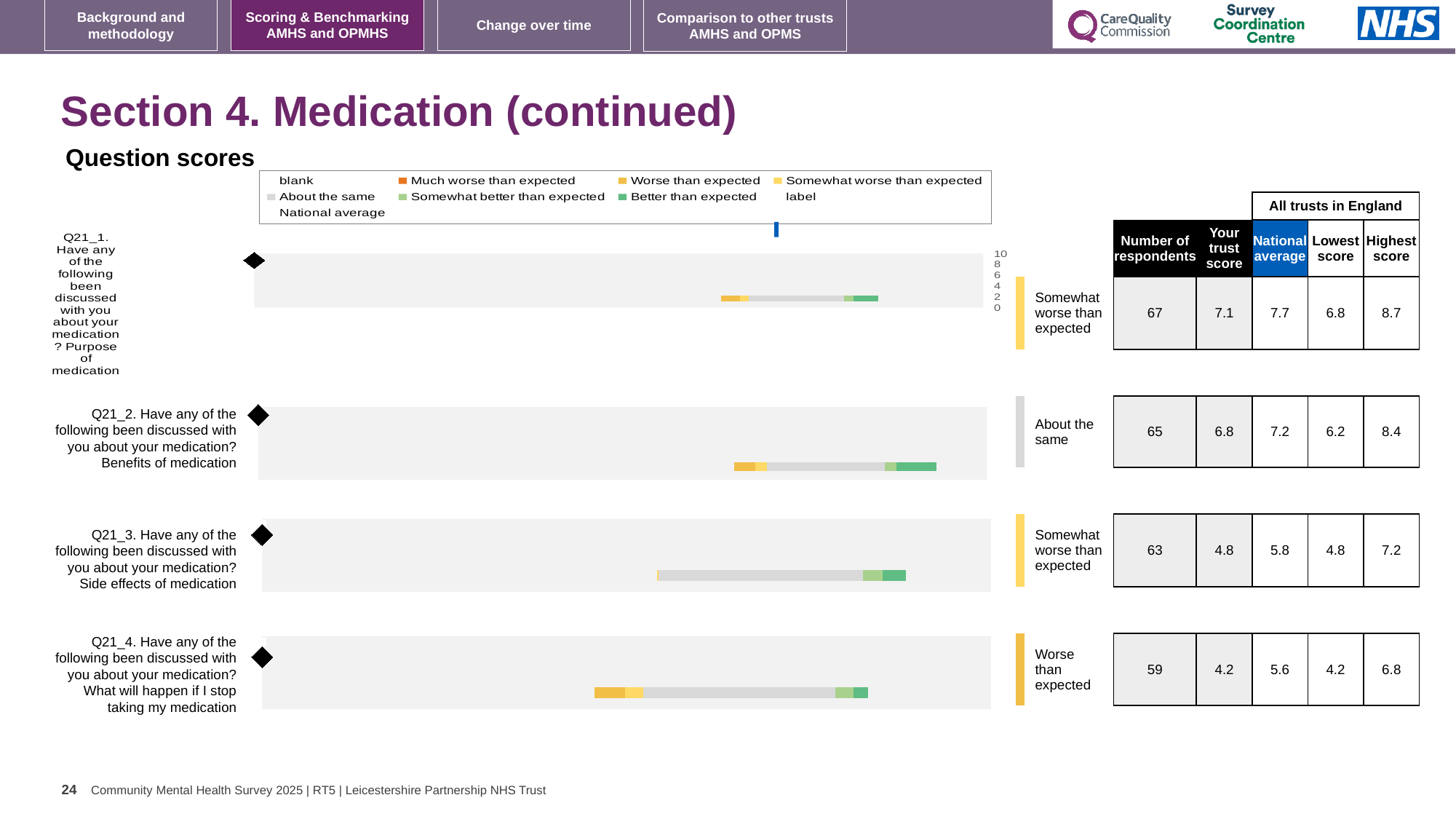
For the Q21_3 chart (Side effects of medication), what is the national average? 5.8 How many question charts (Q21 items) are shown on the slide? 4 What benchmark rating label is shown next to the Q21_2 chart? About the same For the Q21_2 chart (Benefits of medication), what is the 'Your trust score' value? 6.8 Which question has the lowest national average? Q21_4 (What will happen if I stop taking my medication) Which question has the highest 'Your trust score'? Q21_1 (Purpose of medication) For the Q21_1 chart, what is the difference between the highest score and the lowest score? 1.9 For the Q21_2 chart, which is larger: the trust score or the national average? National average For the Q21_4 chart (What will happen if I stop taking my medication), how many respondents are there? 59 What benchmark rating label is shown next to the Q21_4 chart? Worse than expected What kind of chart is used for the question scores on this slide? bar chart For the Q21_1 chart (Purpose of medication), what is the highest score among all trusts in England? 8.7